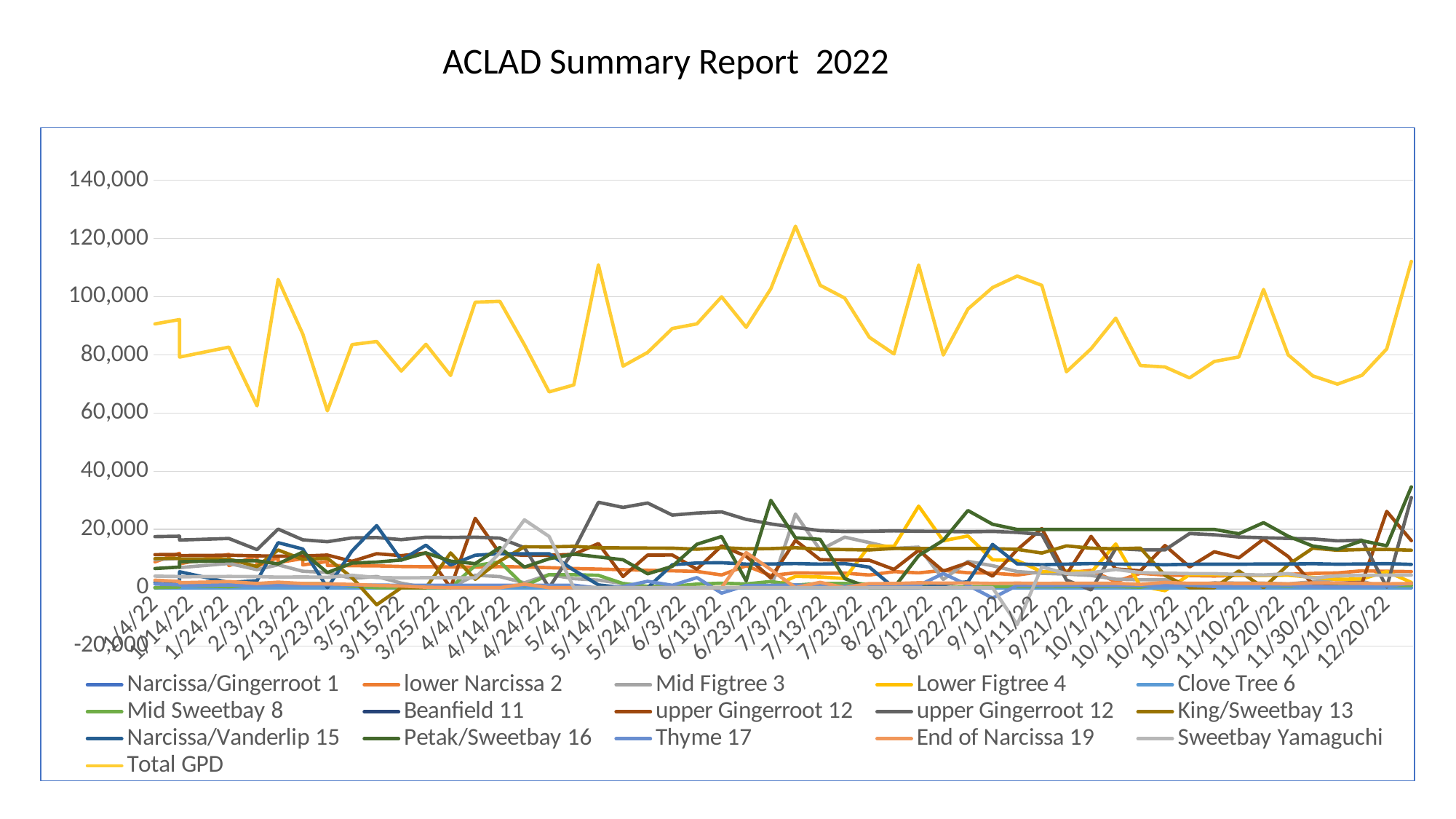
Is the value of Total GPD at 7/3/22 greater or less than 100,000? greater Is the value of Total GPD at 1/4/22 greater or less than 80,000? greater What is the highest value shown on the vertical axis? 140,000 Is the value of Total GPD at 2/23/22 greater or less than 80,000? less Which series has the highest values across the whole chart? Total GPD What kind of chart is shown on the slide? line chart How many series does the legend list? 16 Does the Total GPD series rise or fall between 2/3/22 and 2/13/22? rise What is the title of the chart? ACLAD Summary Report 2022 Which is larger for Total GPD: the value at 7/3/22 or the value at 2/23/22? 7/3/22